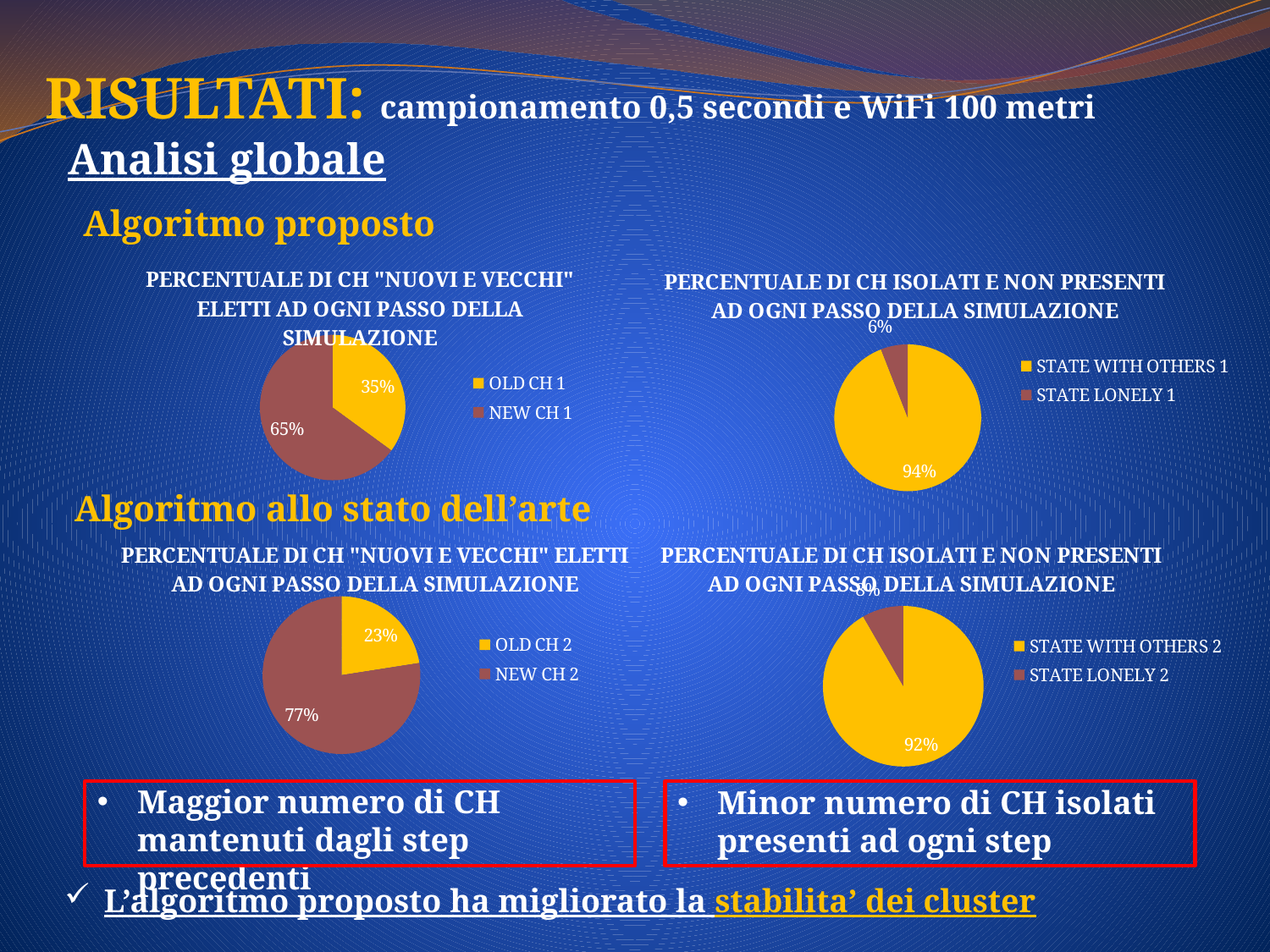
In the bottom-right pie chart (Algoritmo allo stato dell'arte, CH isolati), which slice is larger, STATE WITH OTHERS 2 or STATE LONELY 2? STATE WITH OTHERS 2 In the top-left pie chart (Algoritmo proposto, CH "nuovi e vecchi"), what percentage is shown for NEW CH 1? 65% In the top-right pie chart (Algoritmo proposto, CH isolati), what percentage is shown for STATE LONELY 1? 6% In the bottom-right pie chart (Algoritmo allo stato dell'arte, CH isolati), what percentage is shown for STATE WITH OTHERS 2? 92% What type of chart is used for all four charts on the slide? Pie chart How many entries does the legend of the top-right pie chart (Algoritmo proposto, CH isolati) list? 2 In the top-right pie chart (Algoritmo proposto, CH isolati), what percentage is shown for STATE WITH OTHERS 1? 94% In the bottom-left pie chart (Algoritmo allo stato dell'arte, CH "nuovi e vecchi"), what percentage is shown for OLD CH 2? 23% In the bottom-left pie chart (Algoritmo allo stato dell'arte, CH "nuovi e vecchi"), what percentage is shown for NEW CH 2? 77% In the top-left pie chart (Algoritmo proposto, CH "nuovi e vecchi"), which slice is larger, OLD CH 1 or NEW CH 1? NEW CH 1 In the bottom-left pie chart (Algoritmo allo stato dell'arte, CH "nuovi e vecchi"), what is the difference between NEW CH 2 and OLD CH 2? 54% In the top-left pie chart (Algoritmo proposto, CH "nuovi e vecchi"), what percentage is shown for OLD CH 1? 35%